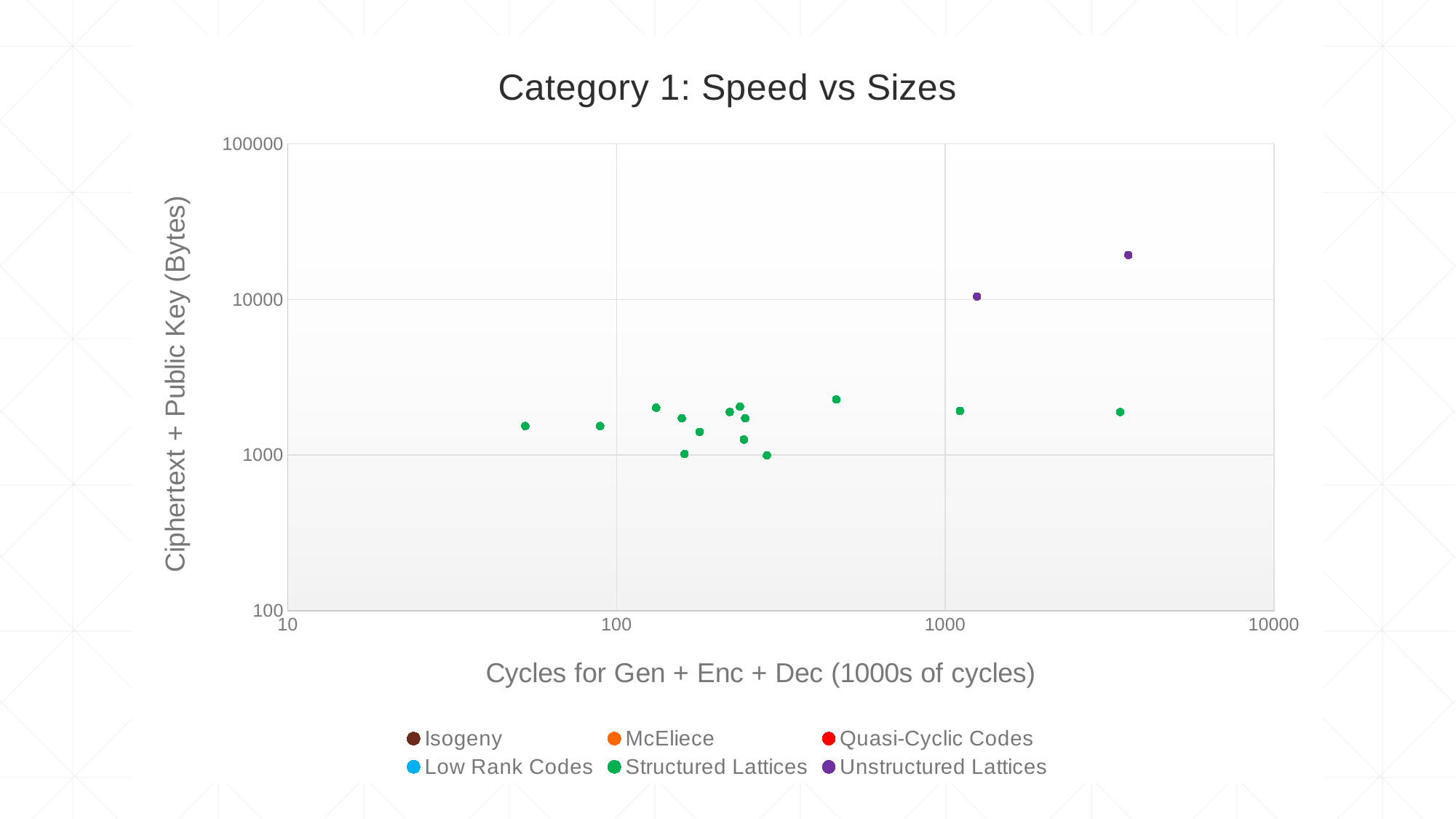
Which series contains the point with the largest Ciphertext + Public Key size? Unstructured Lattices Is the Ciphertext + Public Key size of the highest Unstructured Lattices point greater or less than 10000 bytes? greater Which series contains the point with the smallest Ciphertext + Public Key size? Structured Lattices What is the title of the chart? Category 1: Speed vs Sizes Which series has larger Ciphertext + Public Key sizes overall, Structured Lattices or Unstructured Lattices? Unstructured Lattices How many Unstructured Lattices points are plotted? 2 What kind of chart is shown on the slide? scatter chart Are the cycle counts of both Unstructured Lattices points greater or less than 1000 (1000s of cycles)? greater How many series does the legend list? 6 Are all Structured Lattices points greater or less than 10000 bytes in Ciphertext + Public Key size? less Which legend series have no points plotted on the chart? Isogeny, McEliece, Quasi-Cyclic Codes, Low Rank Codes